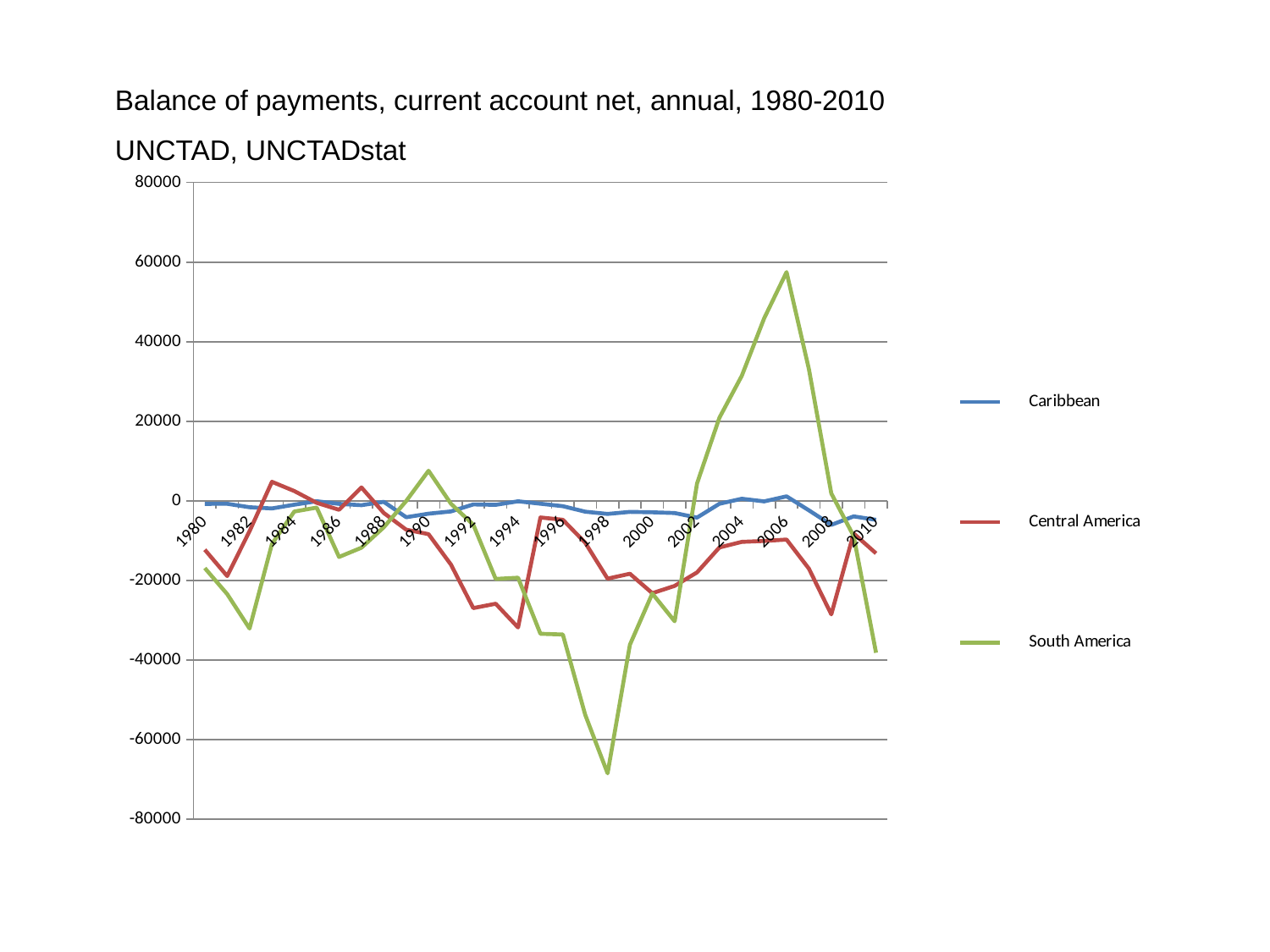
Is the value for South America in 1998 greater or less than -60000? less Does the South America line rise or fall between 2002 and 2006? rise In 2006, which is larger: the value for South America or the value for Central America? South America Is the value for South America in 2006 greater or less than 40000? greater Which series reaches the lowest value on the chart? South America How many series does the legend list? 3 In 1998, which is larger: the value for Central America or the value for South America? Central America Which series is drawn in green? South America What kind of chart is shown on the slide? line chart Does the South America line rise or fall between 2006 and 2010? fall Which series reaches the highest value on the chart? South America Is the value for Central America in 1994 greater or less than -20000? less